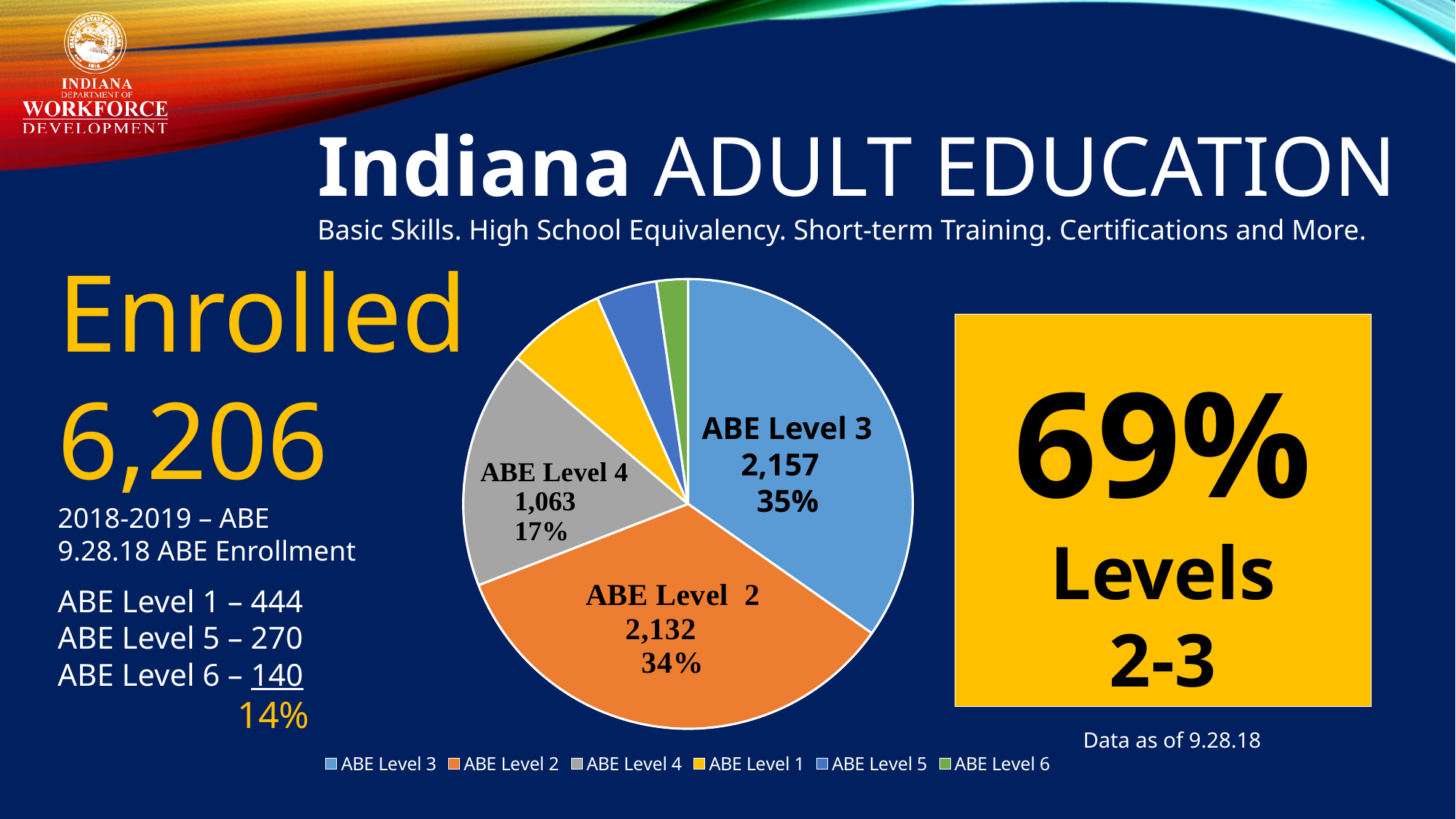
How many entries does the pie chart's legend list? 6 What type of chart is shown on the slide? pie chart What percentage share of the pie does ABE Level 3 represent? 35% Which ABE level has the largest slice in the pie chart? ABE Level 3 Which ABE level has the smallest slice in the pie chart? ABE Level 6 How many slices does the pie chart have? 6 Which is larger in the pie chart, ABE Level 2 or ABE Level 4? ABE Level 2 What percentage share of the pie does ABE Level 4 represent? 17% What is the enrollment value shown for ABE Level 4 in the pie chart? 1,063 What is the enrollment value shown for ABE Level 2 in the pie chart? 2,132 What is the enrollment value shown for ABE Level 3 in the pie chart? 2,157 What is the difference between the ABE Level 3 and ABE Level 2 values in the pie chart? 25